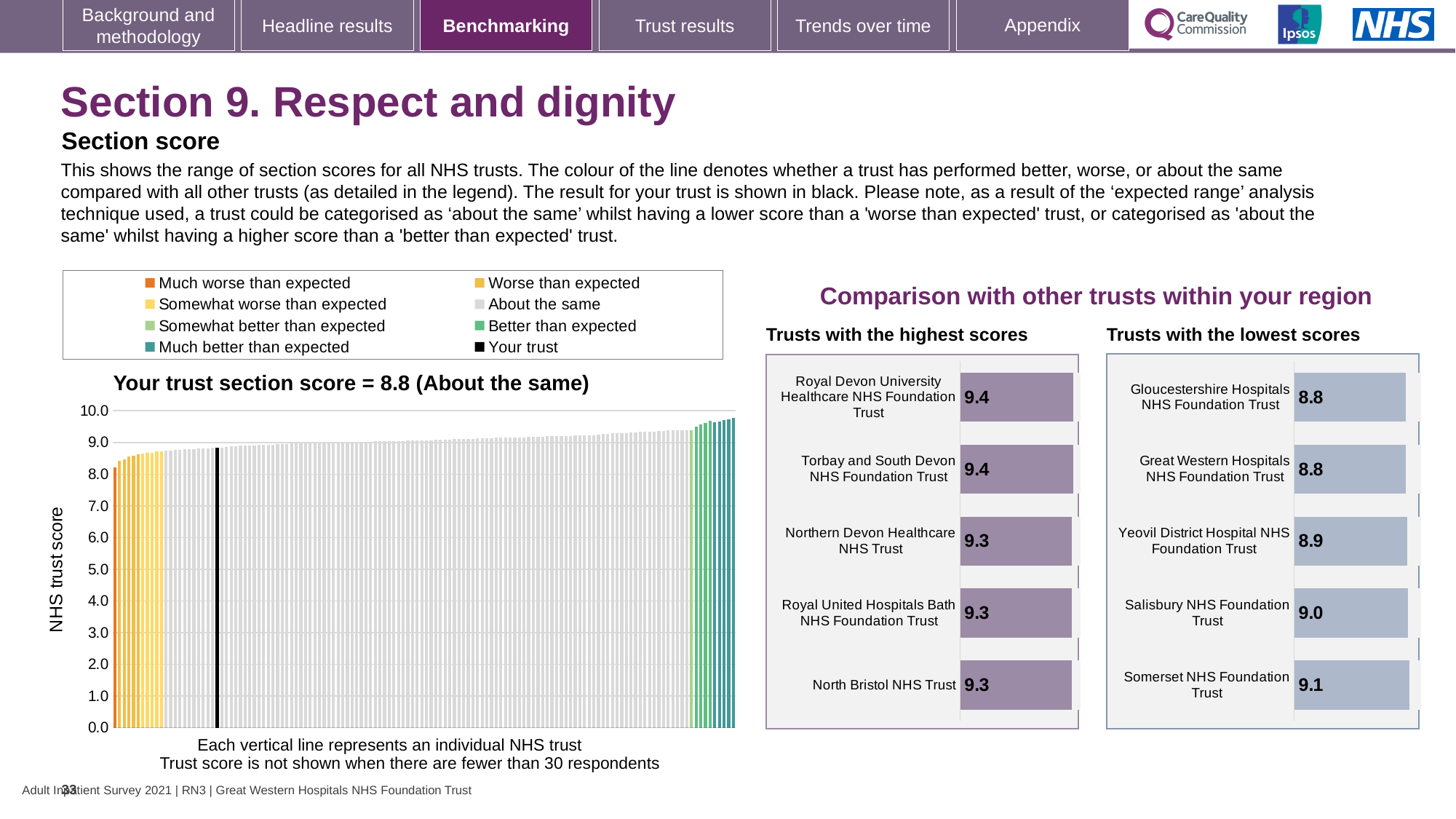
On the 'Your trust section score' chart, what is the section score for your trust? 8.8 On the 'Trusts with the lowest scores' chart, what is the difference between the scores of Somerset NHS Foundation Trust and Gloucestershire Hospitals NHS Foundation Trust? 0.3 On the 'Trusts with the highest scores' chart, how many trusts are shown? 5 On the 'Your trust section score' chart, what is the label of the vertical axis? NHS trust score On the 'Trusts with the highest scores' chart, what is the difference between the scores of Royal Devon University Healthcare NHS Foundation Trust and North Bristol NHS Trust? 0.1 On the 'Trusts with the lowest scores' chart, which trust has the highest score? Somerset NHS Foundation Trust On the 'Your trust section score' chart, is the value of the leftmost (lowest) bar greater or less than 9.0? less On the 'Your trust section score' chart, what category is your trust placed in? About the same On the 'Your trust section score' chart, do the bars rise or fall from left to right? rise On the 'Trusts with the highest scores' chart, what is the score for Northern Devon Healthcare NHS Trust? 9.3 What kind of chart is the 'Your trust section score' chart? bar chart How many entries does the legend above the 'Your trust section score' chart list? 8